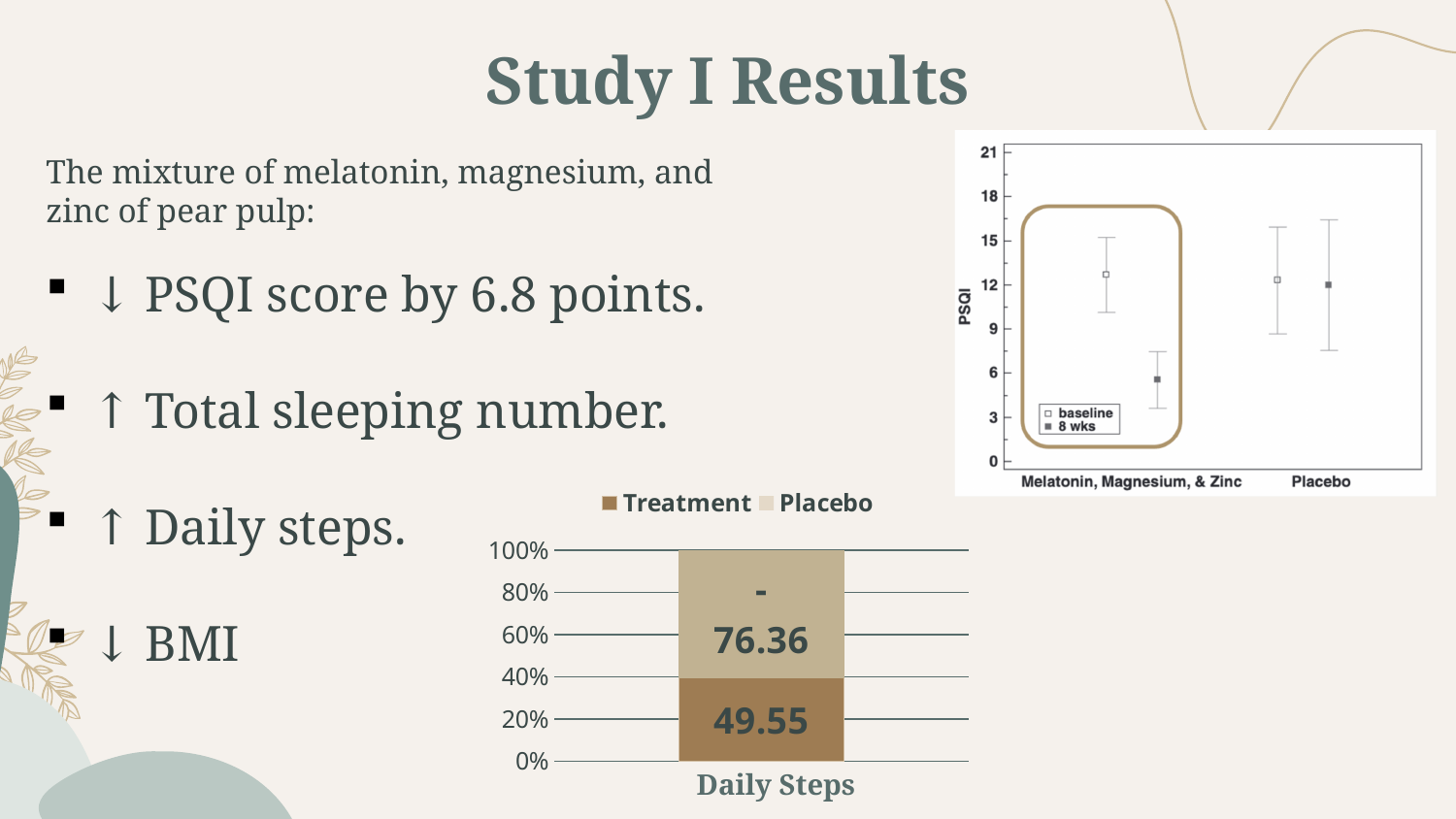
How many series does the legend of the Daily Steps chart list? 2 In the PSQI chart on the right, how many series does the legend list? 2 In the Daily Steps chart, what is the value for Placebo? -76.36 In the PSQI chart on the right, is the 8 wks value for the Melatonin, Magnesium, & Zinc group greater or less than 9? less In the Daily Steps chart, what is the value for Treatment? 49.55 What kind of chart is the Daily Steps chart? Stacked bar chart How many categories are shown on the x axis of the Daily Steps chart? 1 In the PSQI chart on the right, what is the label of the y axis? PSQI In the Daily Steps chart, which series has the larger value, Treatment or Placebo? Treatment In the Daily Steps chart, what is the difference between the Placebo value and the Treatment value? 125.91 In the PSQI chart on the right, how many groups are shown on the x axis? 2 In the PSQI chart on the right, which group has the higher 8 wks PSQI value, Melatonin, Magnesium, & Zinc or Placebo? Placebo